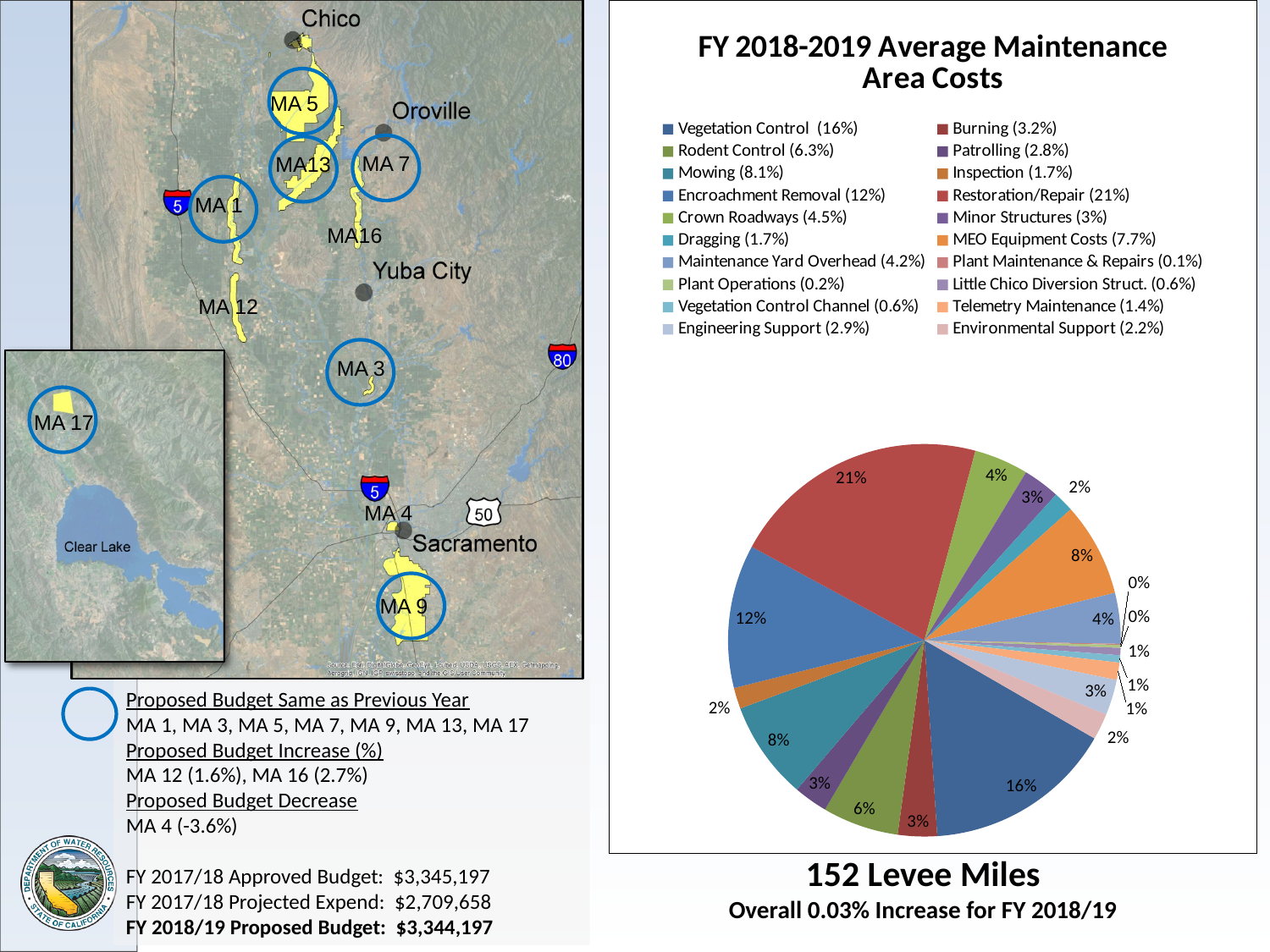
According to the legend, what share of costs is MEO Equipment Costs? 7.7% According to the legend, what share of costs is Restoration/Repair? 21% According to the legend, what share of costs is Engineering Support? 2.9% What is the title of the chart? FY 2018-2019 Average Maintenance Area Costs Which has a larger share, Mowing or Rodent Control? Mowing What type of chart is shown on the slide? pie chart Which category has the largest share of the pie? Restoration/Repair According to the legend, what share of costs is Encroachment Removal? 12% According to the legend, what share of costs is Vegetation Control? 16% How many categories does the legend list? 20 How many percentage points larger is the Restoration/Repair share than the Vegetation Control share? 5 Which category has the smallest share of the pie? Plant Maintenance & Repairs